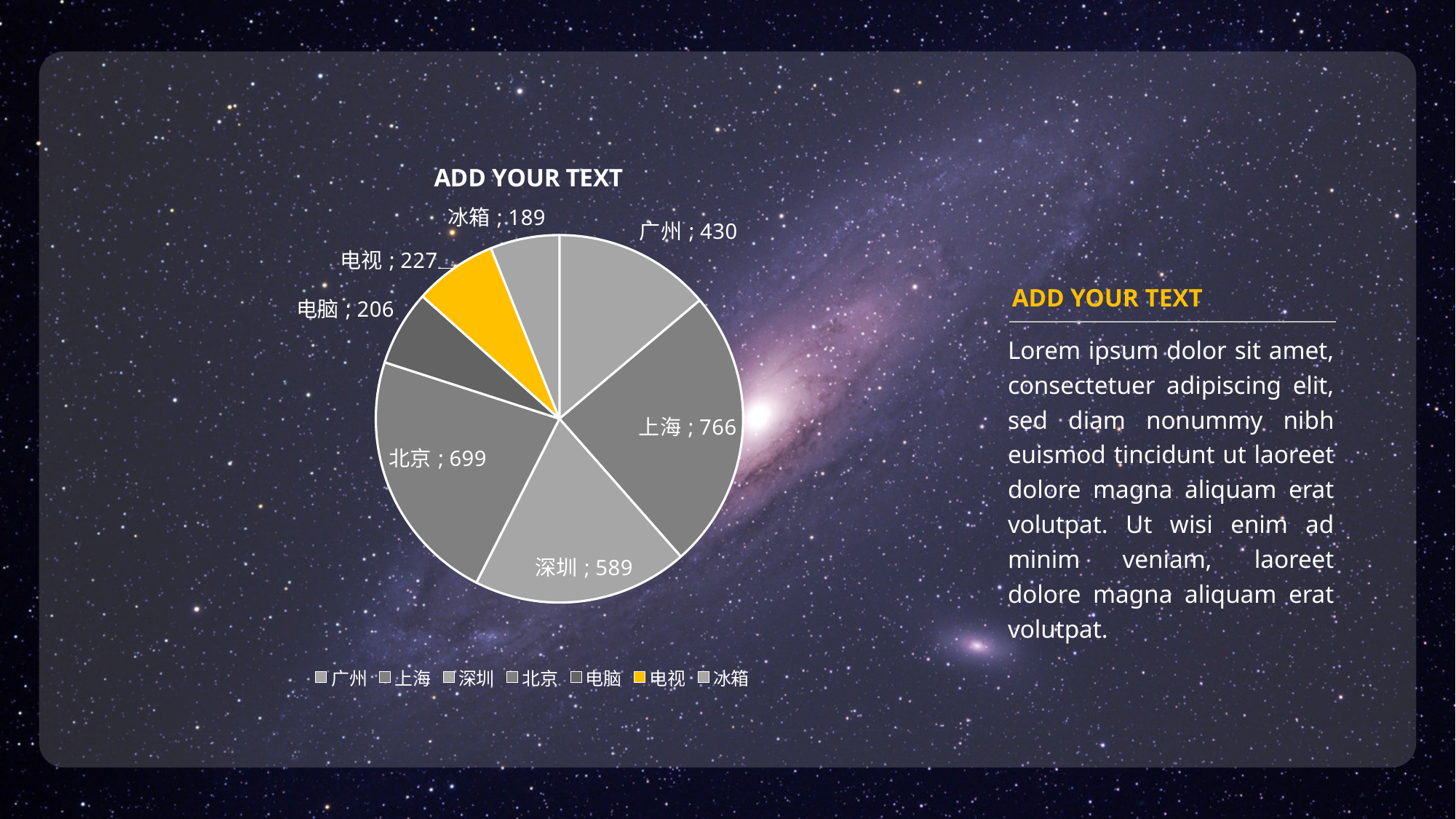
Which category's slice is coloured yellow in the pie chart? 电视 What is the title of the chart? ADD YOUR TEXT How many categories are shown in the pie chart? 7 Which category has the smallest slice in the pie chart? 冰箱 What is the difference between the values for 电视 and 电脑? 21 Which is larger, the value for 广州 or the value for 深圳? 深圳 Which category has the largest slice in the pie chart? 上海 What is the value for 电脑 in the pie chart? 206 What is the value for 上海 in the pie chart? 766 What is the value for 冰箱 in the pie chart? 189 What is the difference between the values for 上海 and 北京? 67 What kind of chart is shown on the slide? Pie chart